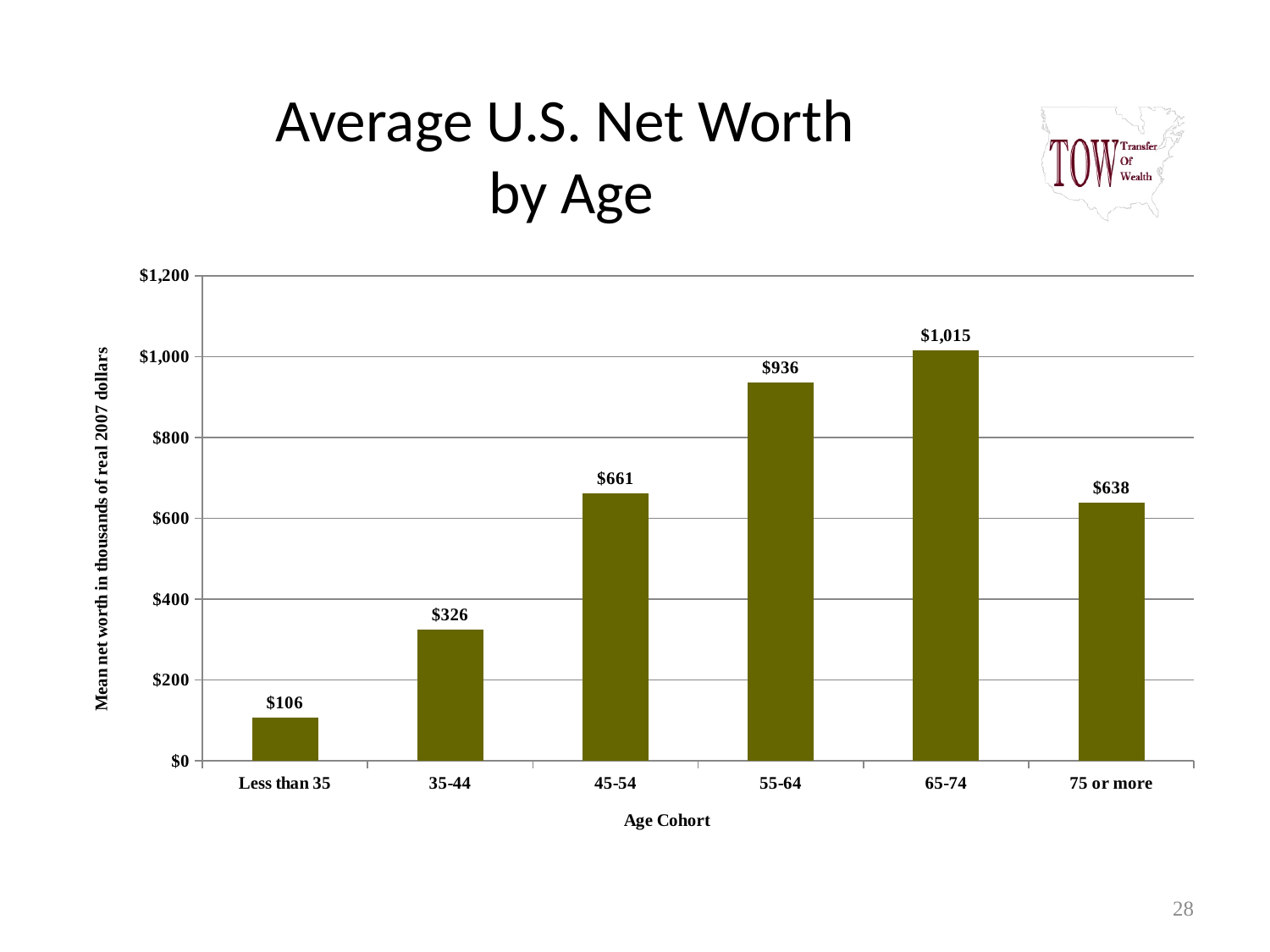
How many age cohorts are shown in the chart? 6 What is the difference in mean net worth between the 65-74 and 55-64 age cohorts? $79 Which age cohort has the lowest mean net worth? Less than 35 What is the difference in mean net worth between the 35-44 and Less than 35 age cohorts? $220 What is the mean net worth for the 45-54 age cohort? $661 Which age cohort has the highest mean net worth? 65-74 What is the mean net worth for the Less than 35 age cohort? $106 What is the label of the x axis? Age Cohort What is the mean net worth for the 75 or more age cohort? $638 Is the value for the 55-64 age cohort greater or less than $800? greater Which has a larger mean net worth, the 45-54 cohort or the 75 or more cohort? 45-54 What kind of chart is shown on the slide? Bar chart